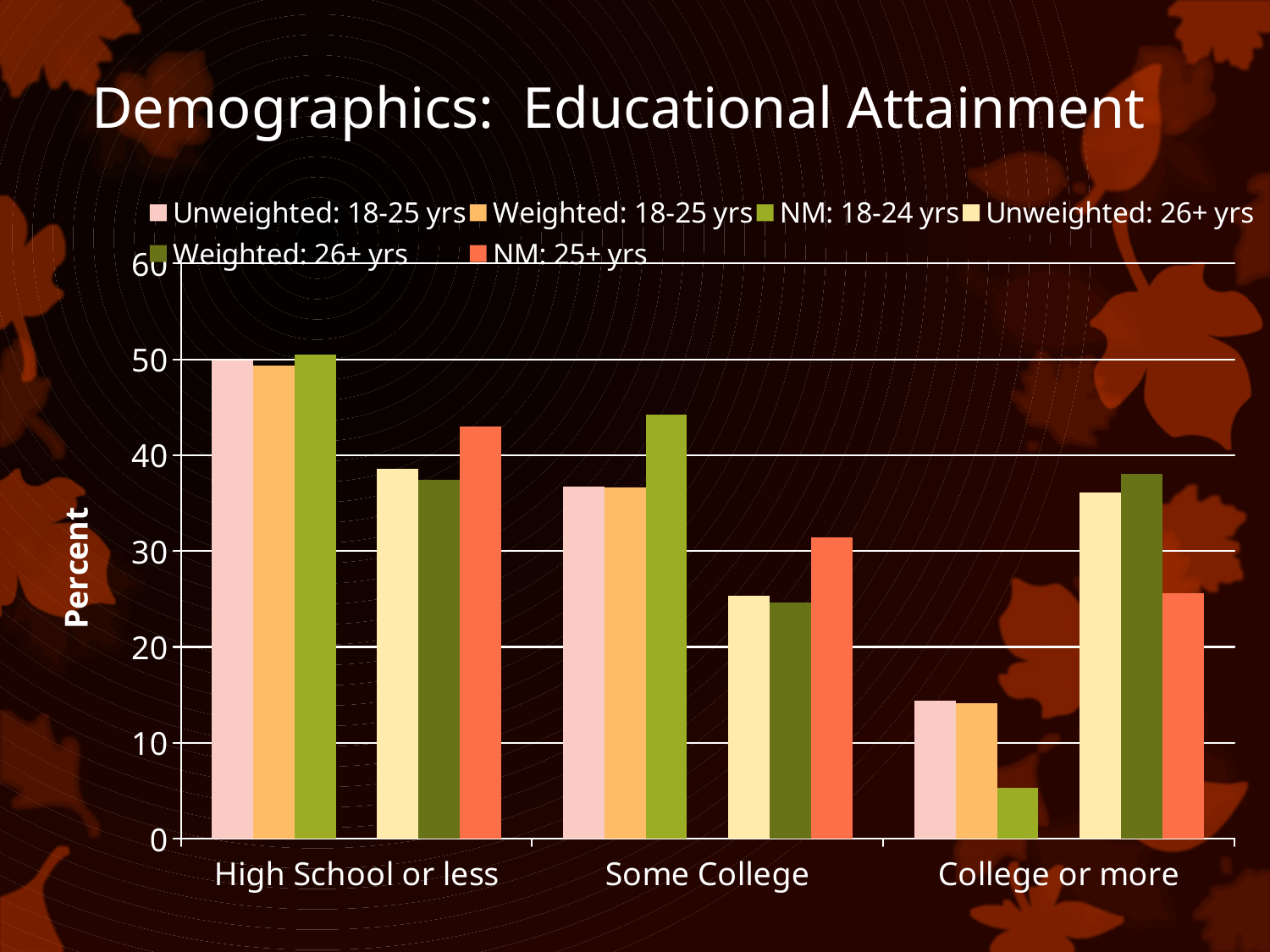
Do the values for Unweighted: 18-25 yrs rise or fall from High School or less to College or more? fall Is the value for Unweighted: 26+ yrs in the Some College category greater or less than 30? less How many series does the legend list? 6 What kind of chart is shown on the slide? bar chart In the College or more category, which series has the lowest value? NM: 18-24 yrs Is the value for NM: 25+ yrs in the High School or less category greater or less than 40? greater What is the label on the vertical axis? Percent In the Some College category, which series has the highest value? NM: 18-24 yrs How many education categories are shown on the x axis? 3 Is the value for NM: 18-24 yrs in the College or more category greater or less than 10? less In the College or more category, which is larger: Weighted: 26+ yrs or NM: 25+ yrs? Weighted: 26+ yrs